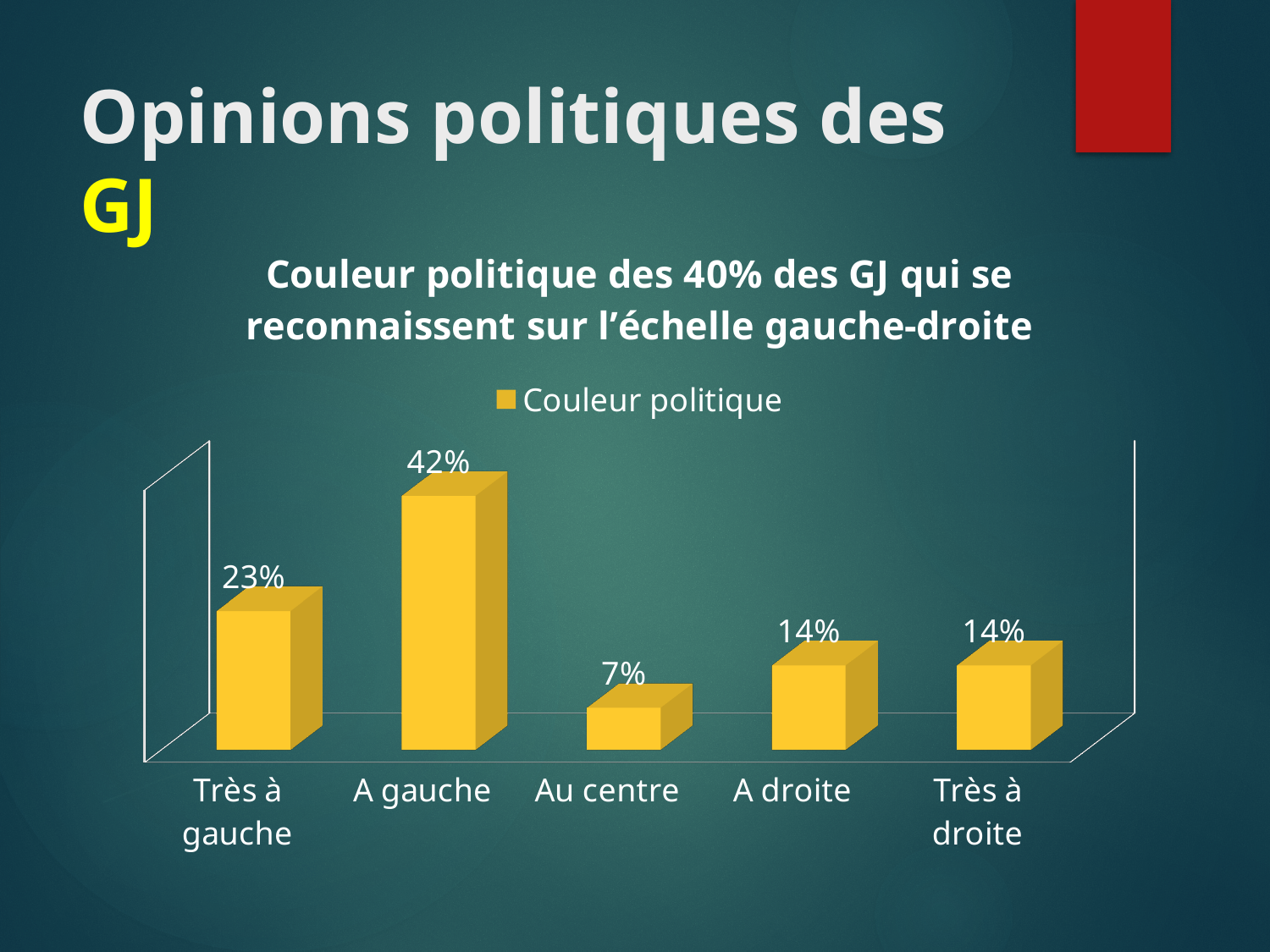
Which category has the highest value? A gauche How many series does the legend list? 1 How many categories are shown on the x axis? 5 Which category has the lowest value? Au centre What is the value for "A droite"? 14% What is the name of the series shown in the legend? Couleur politique What is the value for "Très à gauche"? 23% What is the value for "A gauche"? 42% What is the difference between the values for "A gauche" and "Très à gauche"? 19% What is the value for "Au centre"? 7% What kind of chart is shown on the slide? Bar chart Which is larger, the value for "Très à gauche" or the value for "A droite"? Très à gauche